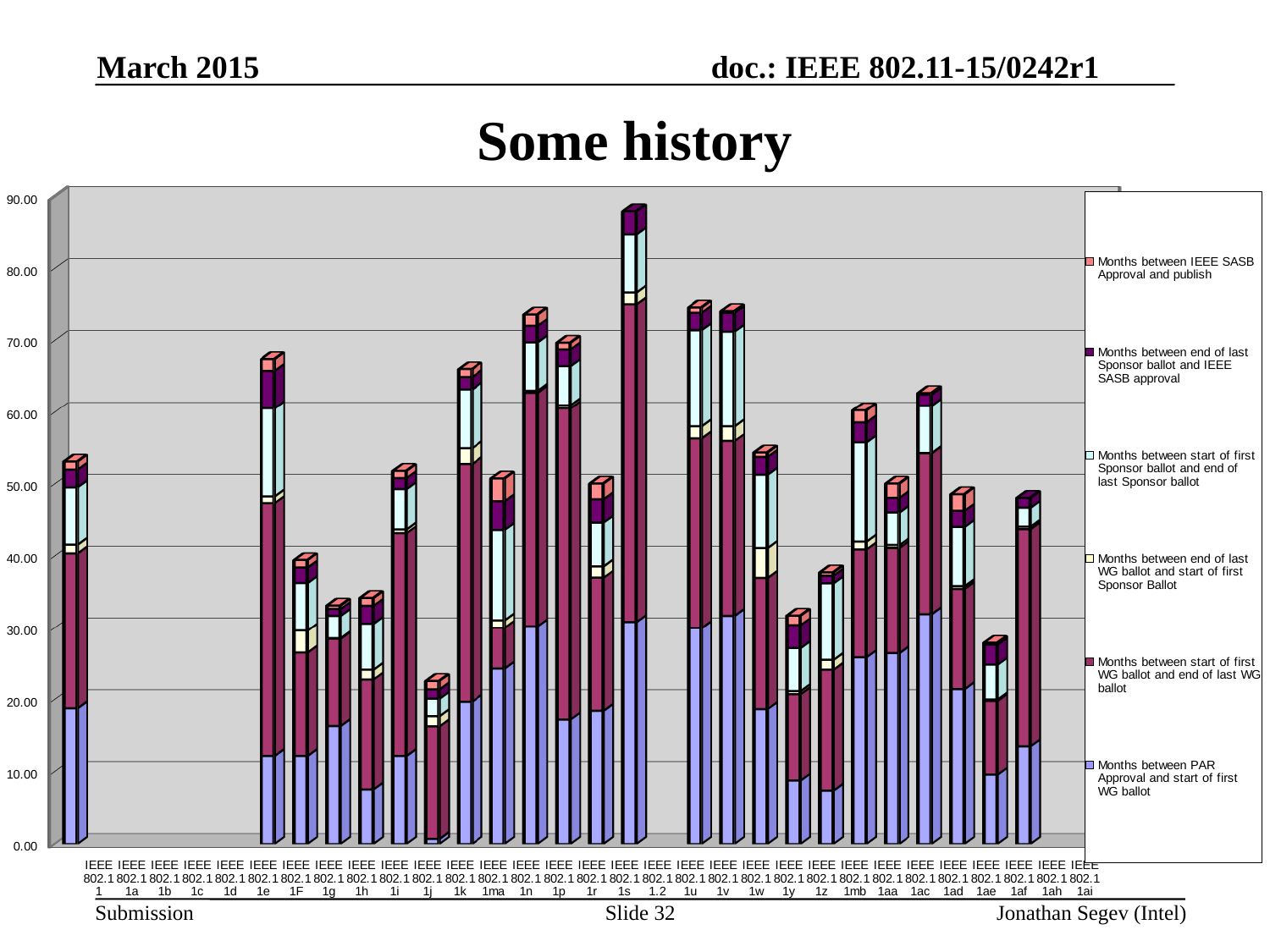
Is the total for IEEE 802.11e greater or less than 60? greater Which series is listed last (at the bottom) in the legend? Months between PAR Approval and start of first WG ballot Is the total for IEEE 802.11s greater or less than 80? greater Which has the larger total, IEEE 802.11k or IEEE 802.11ma? IEEE 802.11k What kind of chart is shown on the slide? Stacked bar chart What is the title of the chart? Some history Is the total for IEEE 802.11j greater or less than 30? less How many categories are labelled along the x axis? 31 Which has the larger total, IEEE 802.11s or IEEE 802.11e? IEEE 802.11s Which category has the tallest stacked bar? IEEE 802.11s How many series does the legend list? 6